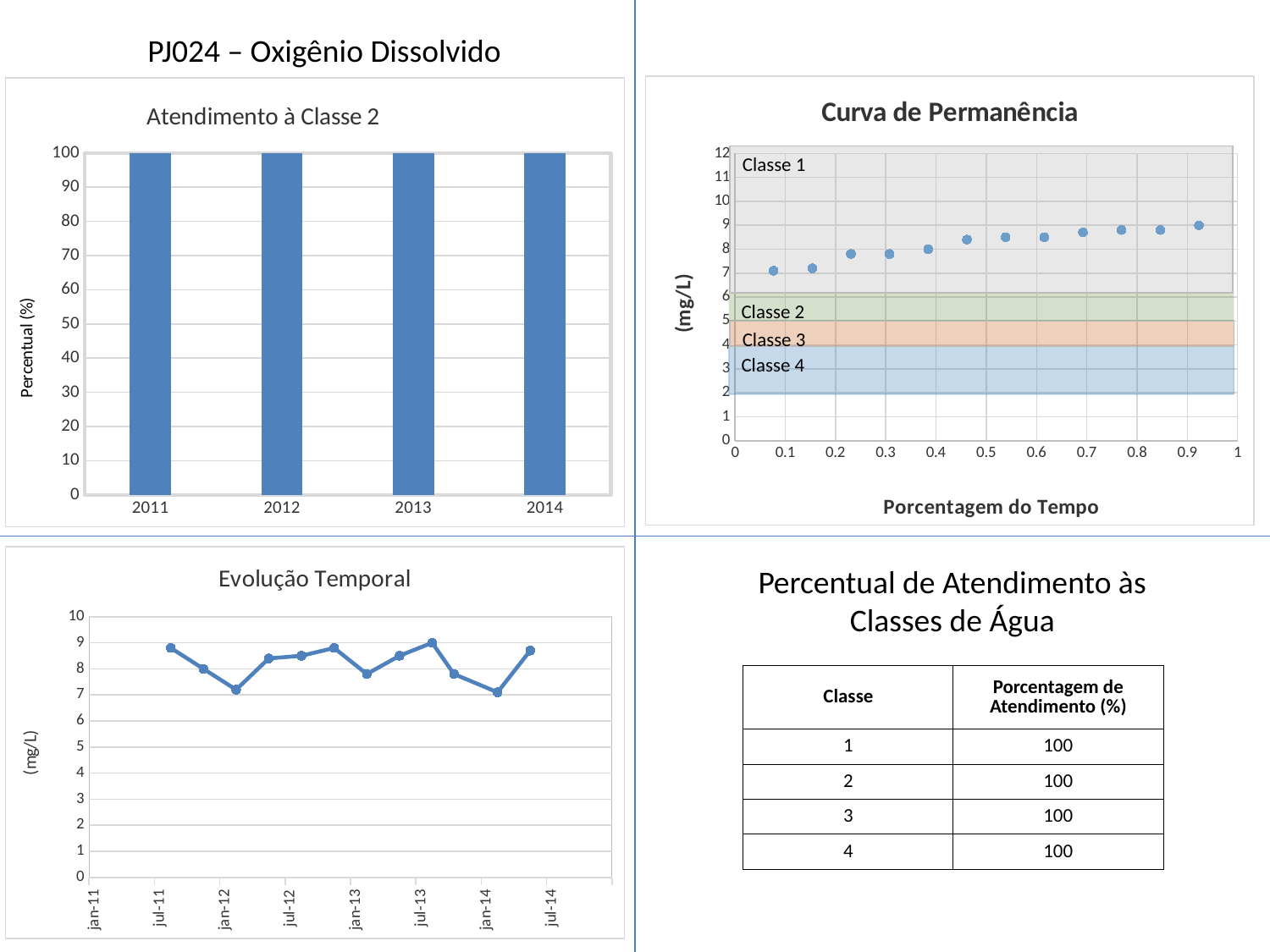
What kind of chart is 'Evolução Temporal'? line chart In the 'Atendimento à Classe 2' chart, what is the value for 2014? 100 What is the x-axis label of the 'Curva de Permanência' chart? Porcentagem do Tempo In the 'Curva de Permanência' chart, do the values rise or fall as the percentage of time increases? rise In the 'Atendimento à Classe 2' chart, what is the difference between the values for 2012 and 2013? 0 What is the y-axis label of the 'Atendimento à Classe 2' chart? Percentual (%) In the 'Evolução Temporal' chart, is the value at jan-12 greater or less than 6? greater In the 'Curva de Permanência' chart, is the value at 0.9 on the x axis greater or less than 8? greater What kind of chart is 'Atendimento à Classe 2'? bar chart In the 'Atendimento à Classe 2' chart, what is the value for 2011? 100 How many years are shown in the 'Atendimento à Classe 2' chart? 4